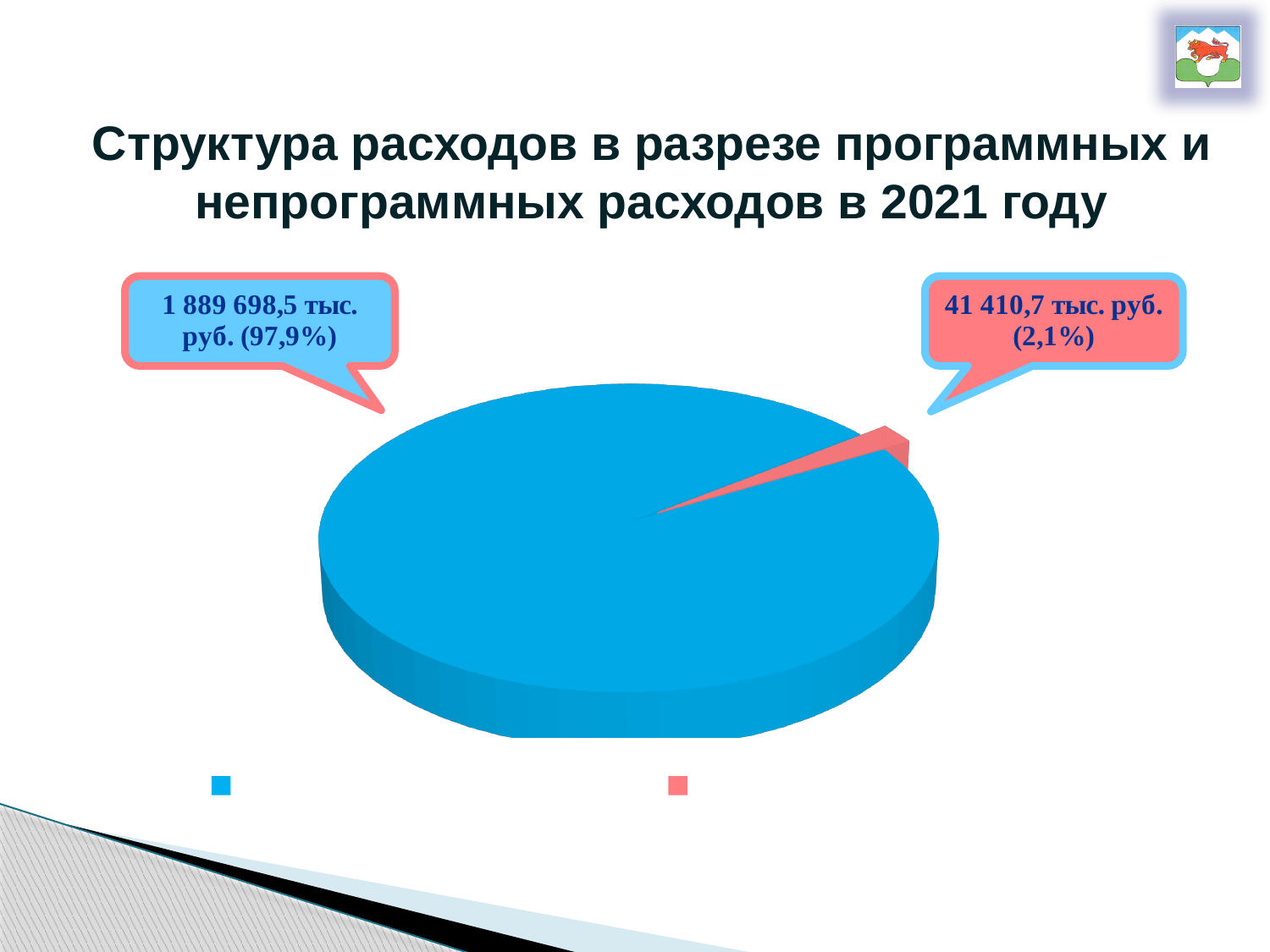
What value is labelled for the red slice of the pie chart? 41 410,7 тыс. руб. What is the difference in percentage points between the blue slice's share and the red slice's share? 95,8% How many entries does the legend below the pie chart show? 2 Which slice of the pie chart is the largest? the blue slice What share of the pie does the red slice represent? 2,1% How many slices does the pie chart have? 2 What value is labelled for the blue slice of the pie chart? 1 889 698,5 тыс. руб. What kind of chart is shown on the slide? pie chart Which slice of the pie chart is the smallest? the red slice Which is larger, the blue slice or the red slice? the blue slice What share of the pie does the blue slice represent? 97,9% What is the title of the slide containing the pie chart? Структура расходов в разрезе программных и непрограммных расходов в 2021 году